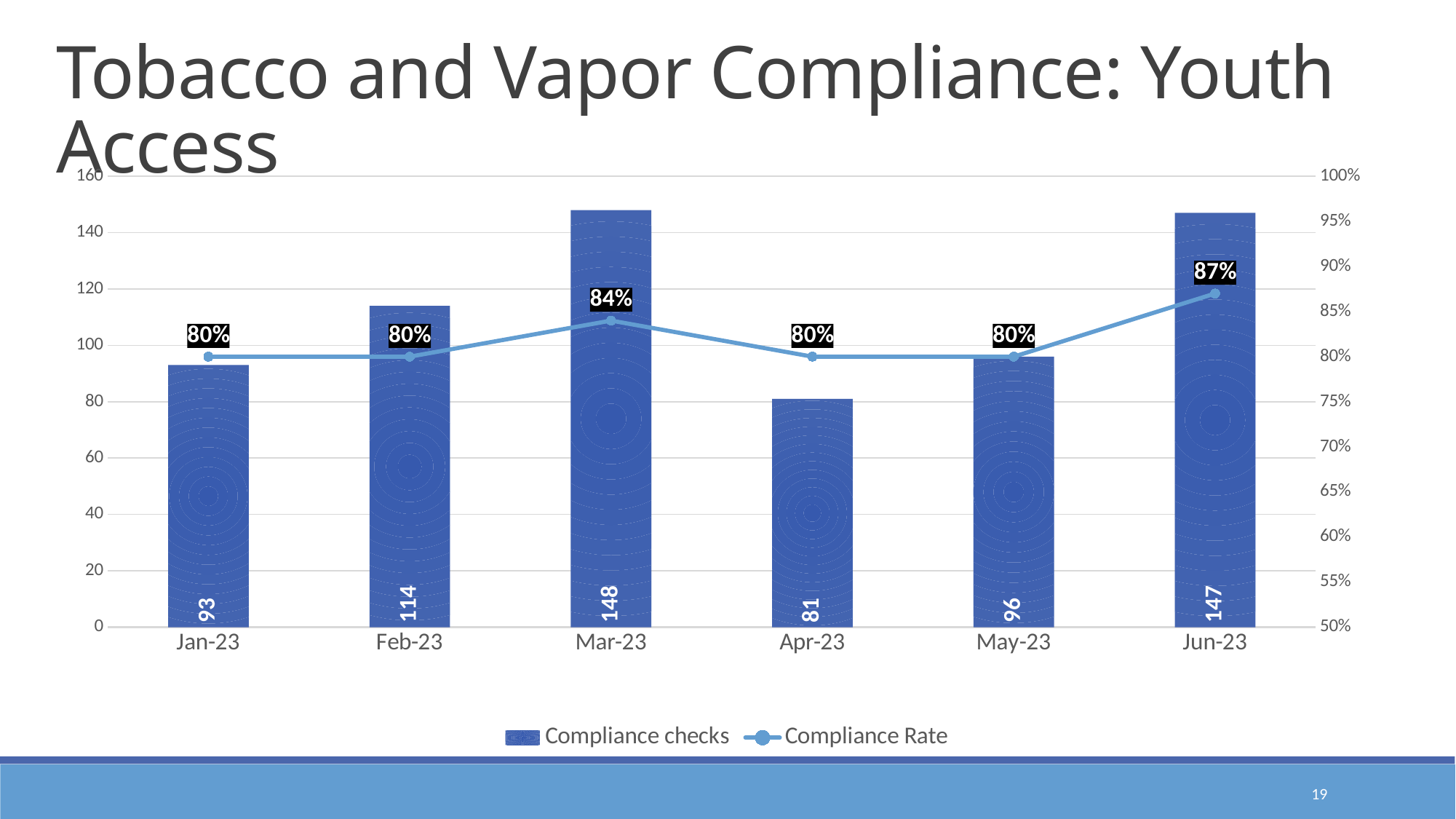
How many compliance checks were conducted in Apr-23? 81 Which month had the highest compliance rate? Jun-23 How many months are shown on the x axis? 6 How many series does the legend list? 2 What was the compliance rate in Jun-23? 87% What is the difference in compliance checks between Feb-23 and Jan-23? 21 Which month had more compliance checks, May-23 or Jun-23? Jun-23 Which month had the lowest number of compliance checks? Apr-23 What kind of chart is used to show the compliance checks? Bar chart What is the title of the slide? Tobacco and Vapor Compliance: Youth Access How many compliance checks were conducted in Mar-23? 148 Which month had the highest number of compliance checks? Mar-23